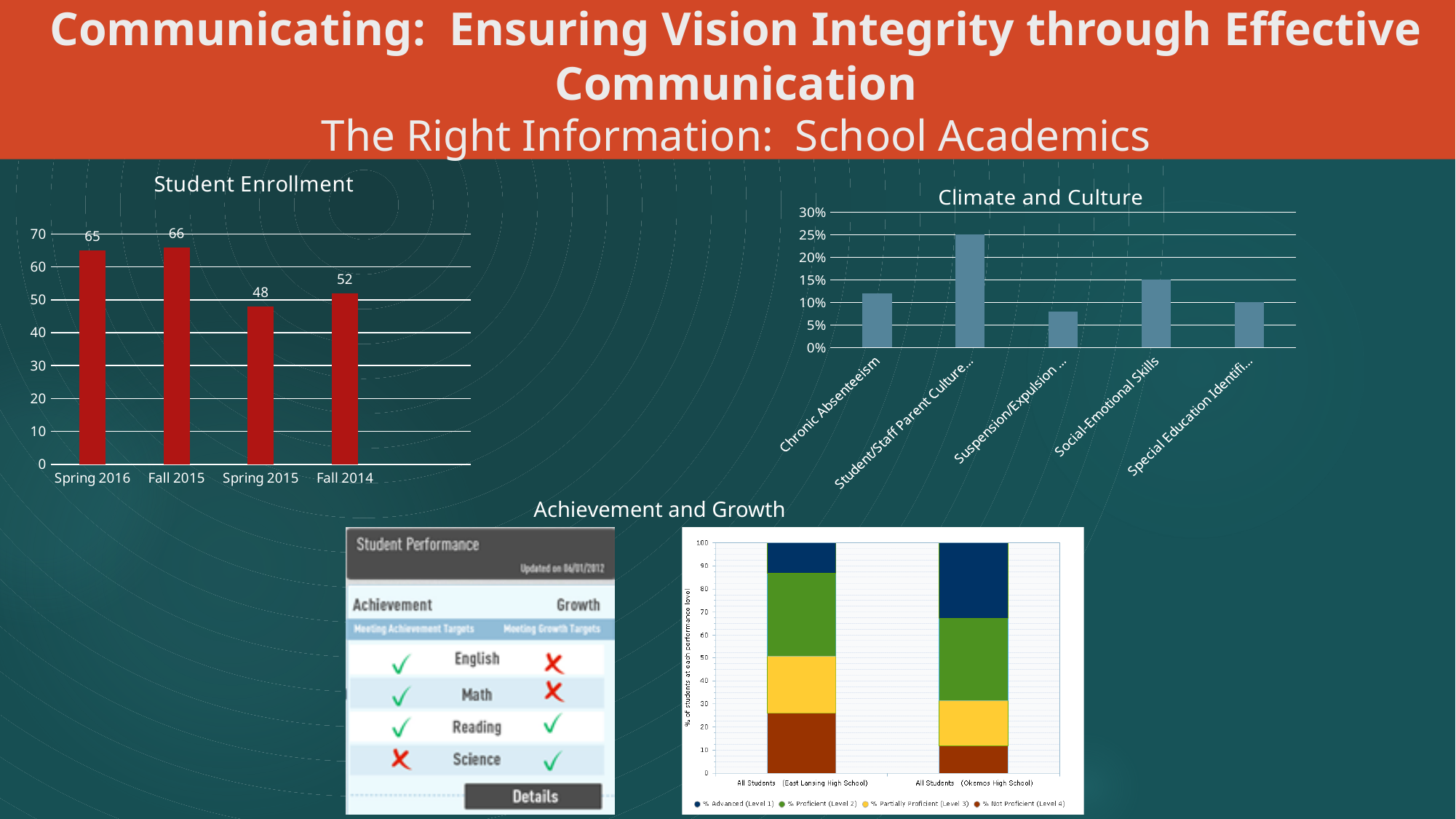
In the Student Enrollment chart, what is the value for Fall 2014? 52 In the Student Enrollment chart, what is the difference between Fall 2015 and Spring 2015? 18 What kind of chart is the Student Enrollment chart? Bar chart How many series does the legend of the Achievement and Growth stacked bar chart list? 4 In the Student Enrollment chart, what is the value for Spring 2016? 65 How many periods are shown in the Student Enrollment chart? 4 In the Student Enrollment chart, which period has the highest enrollment? Fall 2015 In the Climate and Culture chart, which category has the highest value? Student/Staff Parent Culture How many categories are shown in the Climate and Culture chart? 5 In the Climate and Culture chart, which category has the lowest value? Suspension/Expulsion In the Student Enrollment chart, which period has the lowest enrollment? Spring 2015 In the Climate and Culture chart, is the value for Chronic Absenteeism greater or less than 10%? greater